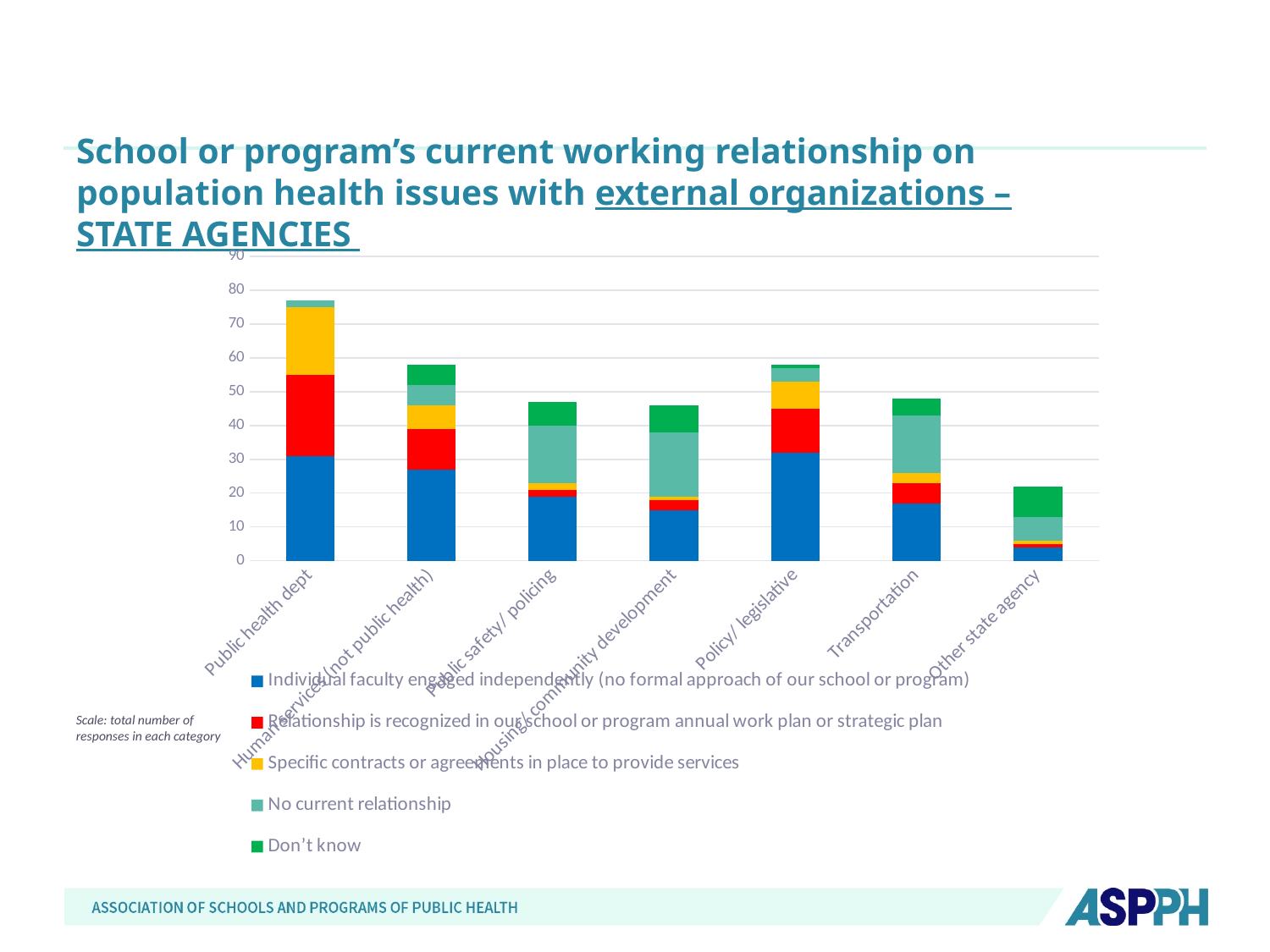
Is the total for Housing/ community development greater or less than 50? less Is the total for Public health dept greater or less than 70? greater Which has the larger total: Policy/ legislative or Housing/ community development? Policy/ legislative Which has the larger total: Human services (not public health) or Public safety/ policing? Human services (not public health) Which category has the shortest stacked bar? Other state agency How many categories are shown along the x axis of the chart? 7 Which legend entry is shown in dark blue? Individual faculty engaged independently (no formal approach of our school or program) Which category has the tallest stacked bar? Public health dept Is the total for Policy/ legislative greater or less than 50? greater How many series does the chart's legend list? 5 What kind of chart is shown on the slide? Stacked bar chart